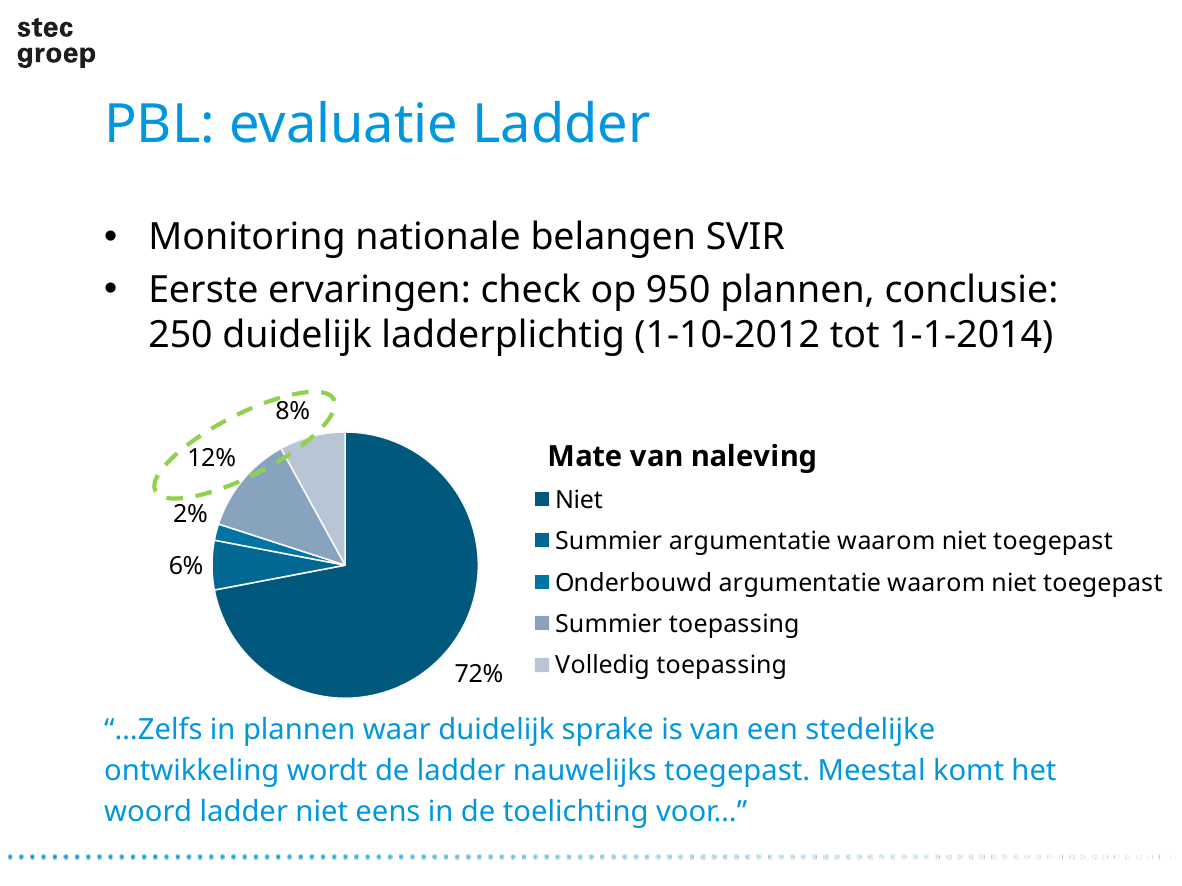
What share of the pie is 'Niet'? 72% What share of the pie is 'Onderbouwd argumentatie waarom niet toegepast'? 2% How many slices does the pie chart have? 5 How many entries does the chart legend list? 5 What share of the pie is 'Volledig toepassing'? 8% What is the difference in percentage points between 'Summier toepassing' and 'Volledig toepassing'? 4 Which category has the smallest slice of the pie? Onderbouwd argumentatie waarom niet toegepast Which category has the largest slice of the pie? Niet What is the title of the chart? Mate van naleving What kind of chart is shown on the slide? pie chart